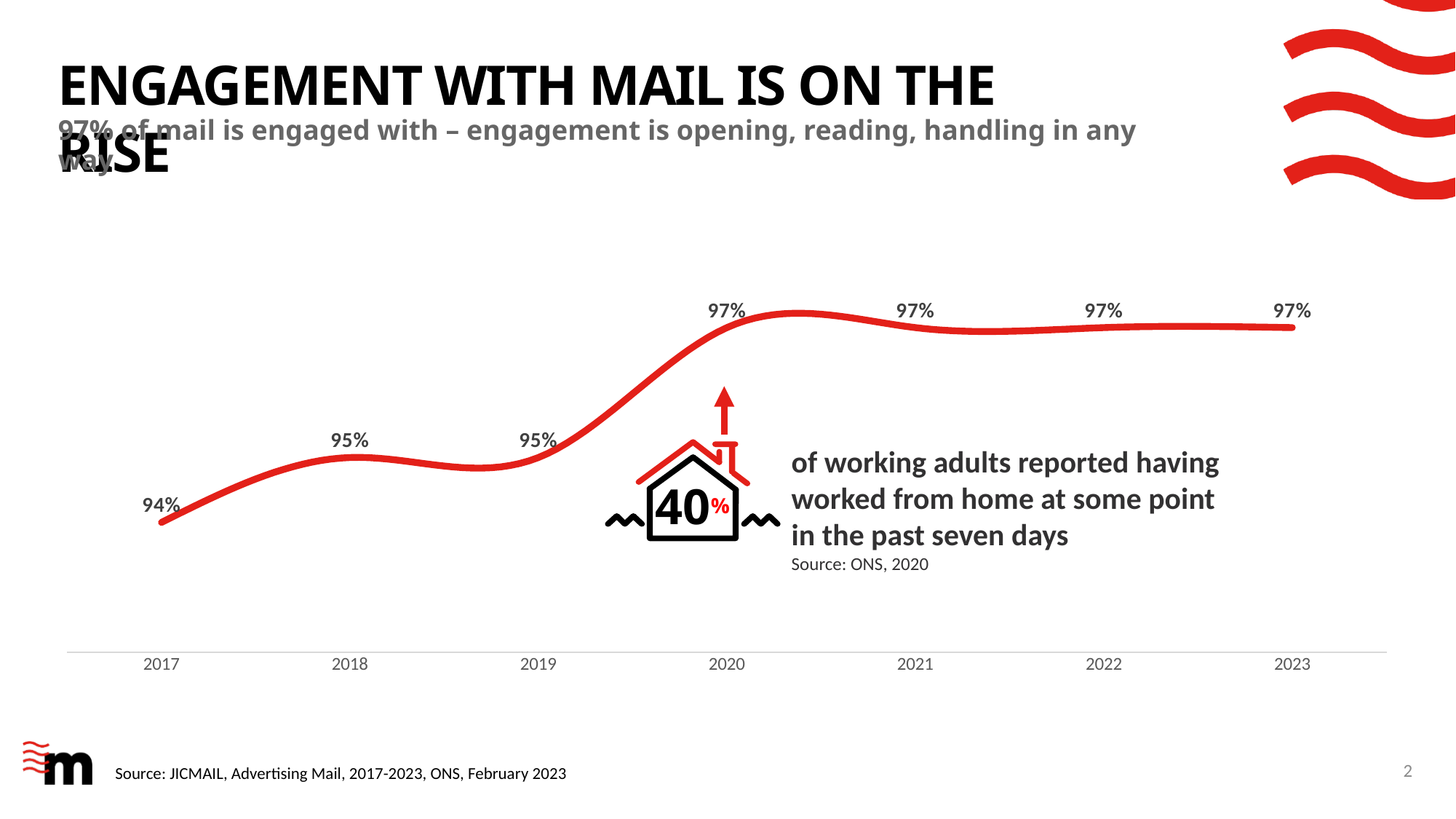
Which year has the lowest engagement value? 2017 What is the engagement value for 2023? 97% How many years are plotted on the x axis? 7 What is the engagement value for 2019? 95% Do the values rise or fall from 2017 to 2020? rise How many years show a value of 97%? 4 What is the difference between the 2018 value and the 2017 value? 1% What is the difference between the 2020 value and the 2017 value? 3% What colour is the line in the chart? red What kind of chart is shown on the slide? line chart What is the engagement value for 2017? 94% Which is larger, the value for 2019 or the value for 2020? 2020